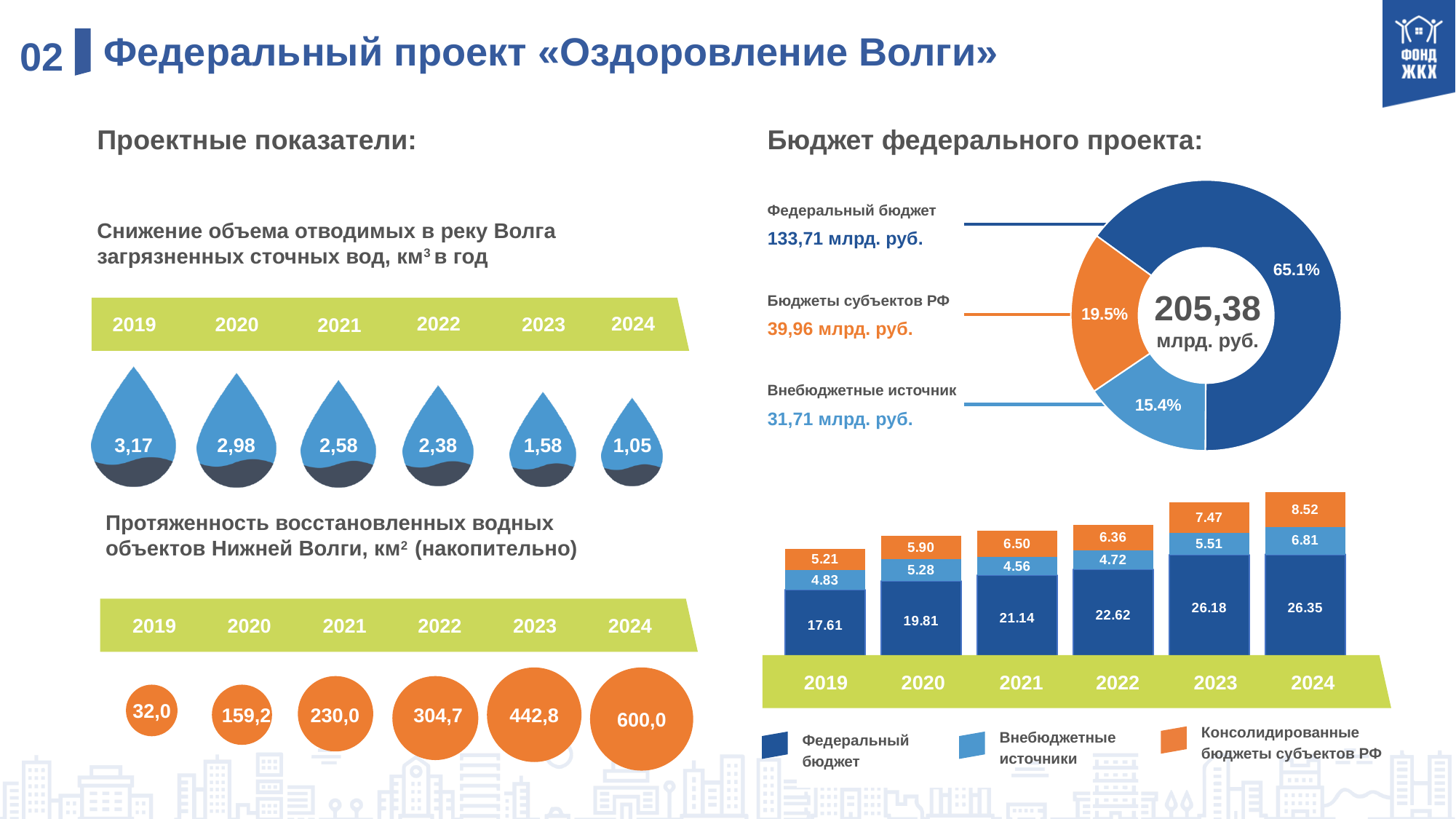
In the donut chart, what total is printed in the centre? 205,38 млрд. руб. In the stacked bar chart at the bottom right, what is the total of the 2019 bar? 27.65 In the donut chart, which source has the smallest share? Внебюджетные источники In the stacked bar chart at the bottom right, which year has the highest Федеральный бюджет value? 2024 In the donut chart, what is the value shown for Внебюджетные источники? 31,71 млрд. руб. In the donut chart under 'Бюджет федерального проекта', what share of the budget comes from the Федеральный бюджет? 65.1% In the stacked bar chart at the bottom right, what is the difference between the Консолидированные бюджеты субъектов РФ values for 2024 and 2019? 3.31 In the stacked bar chart at the bottom right, how many series does the legend list? 3 In the donut chart, how many segments are there? 3 In the stacked bar chart at the bottom right, what is the Федеральный бюджет value for 2022? 22.62 In the stacked bar chart at the bottom right, what is the Внебюджетные источники value for 2020? 5.28 What kind of chart is shown at the bottom right of the slide? Stacked bar chart